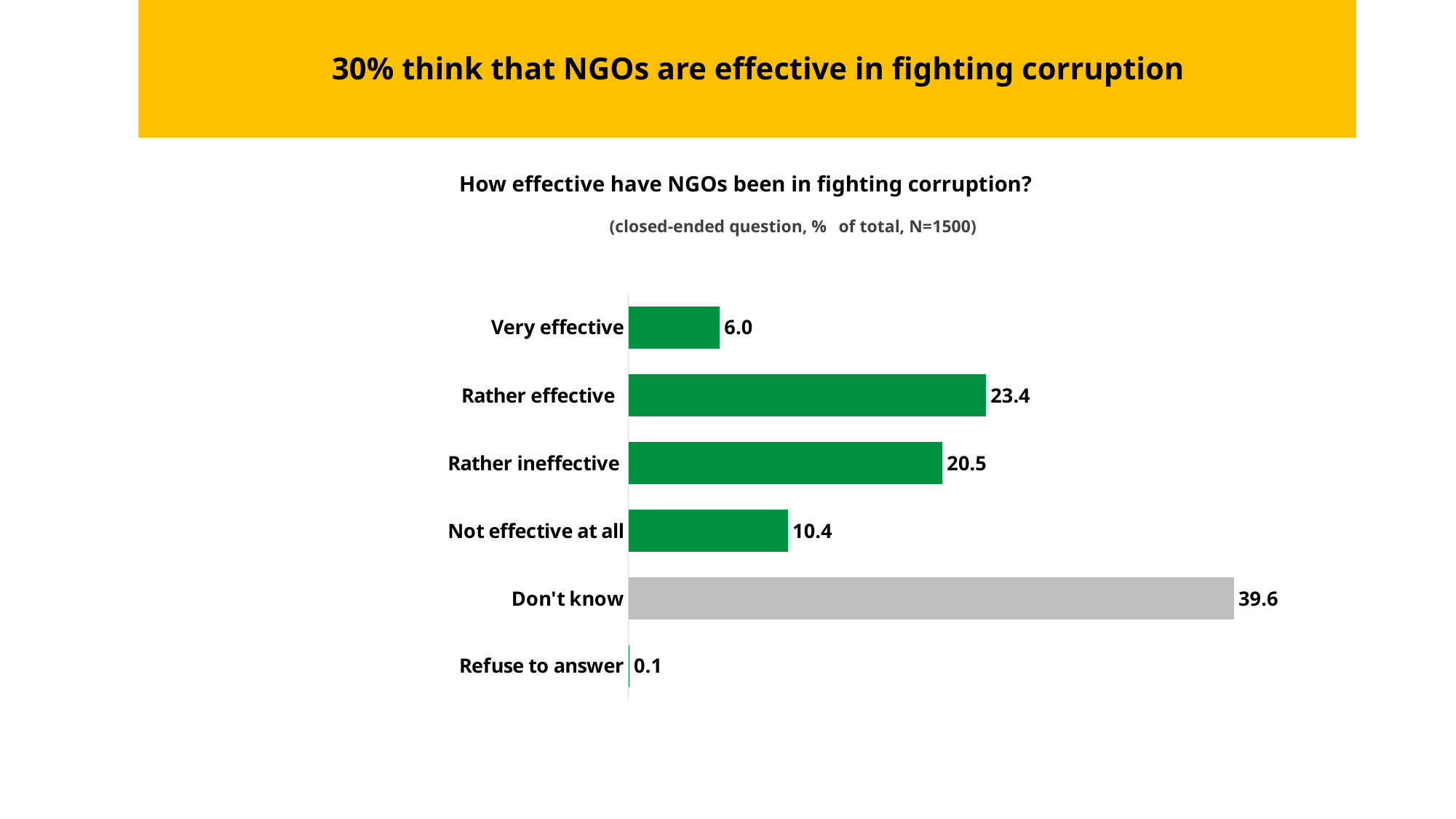
Which bar is coloured grey rather than green? Don't know Which category has the highest value? Don't know How many categories are shown in the chart? 6 What is the difference between "Rather effective" and "Rather ineffective"? 2.9 What is the value for "Rather effective"? 23.4 Which is larger, "Not effective at all" or "Very effective"? Not effective at all Which category has the lowest value? Refuse to answer What is the value for "Refuse to answer"? 0.1 What kind of chart is shown on the slide? Bar chart What is the difference between "Don't know" and "Not effective at all"? 29.2 What is the value for "Very effective"? 6.0 What is the value for "Don't know"? 39.6